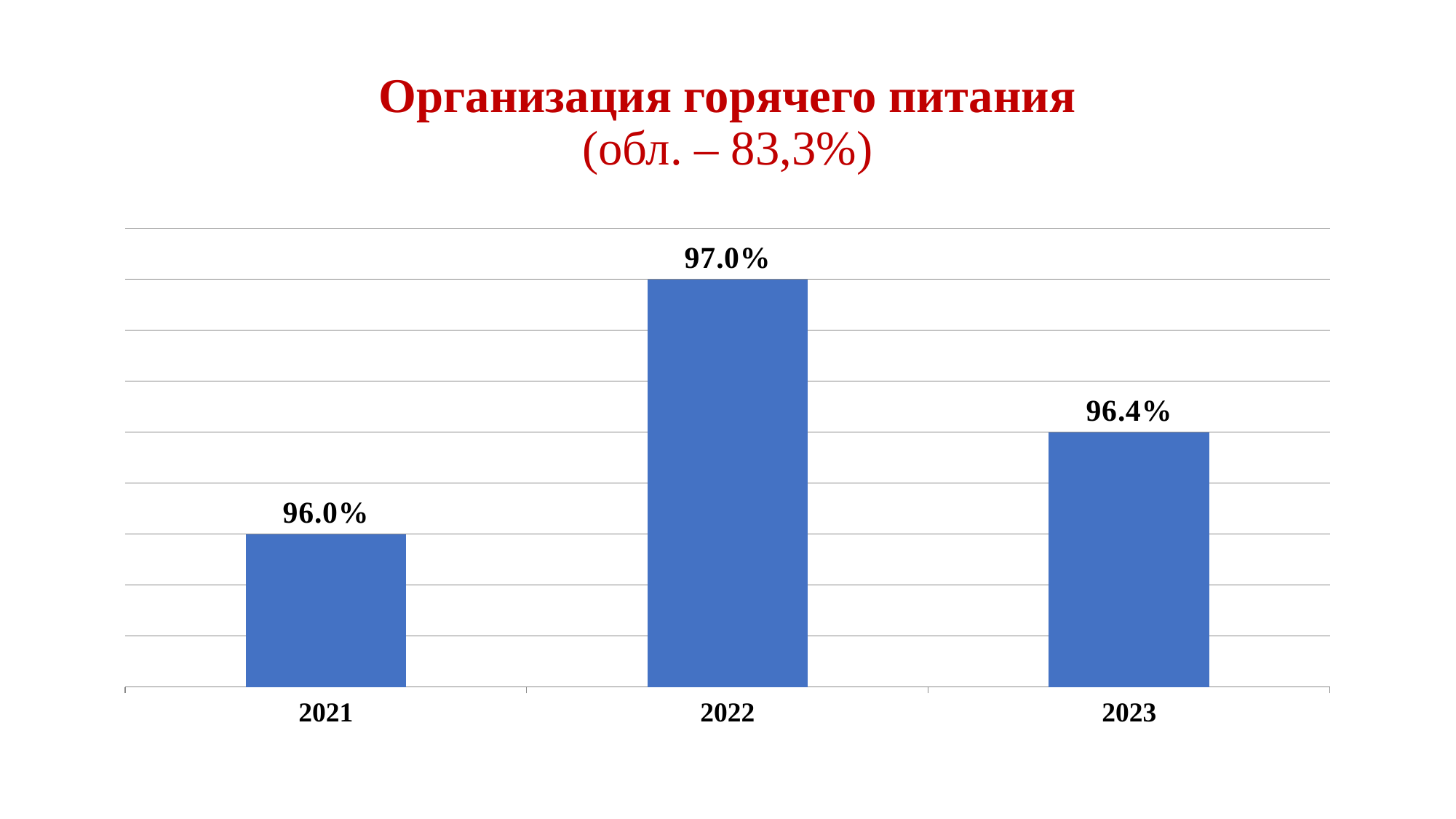
Which year has the lowest value? 2021 How many years are shown on the chart? 3 What is the value for 2021? 96.0% What is the difference between the values for 2022 and 2023? 0.6% What kind of chart is shown on the slide? Bar chart Which year has the highest value? 2022 What is the title of the chart? Организация горячего питания (обл. – 83,3%) What is the difference between the values for 2022 and 2021? 1.0% Which is larger, the value for 2023 or the value for 2021? 2023 Does the value rise or fall from 2022 to 2023? Fall What is the value for 2023? 96.4% What is the value for 2022? 97.0%